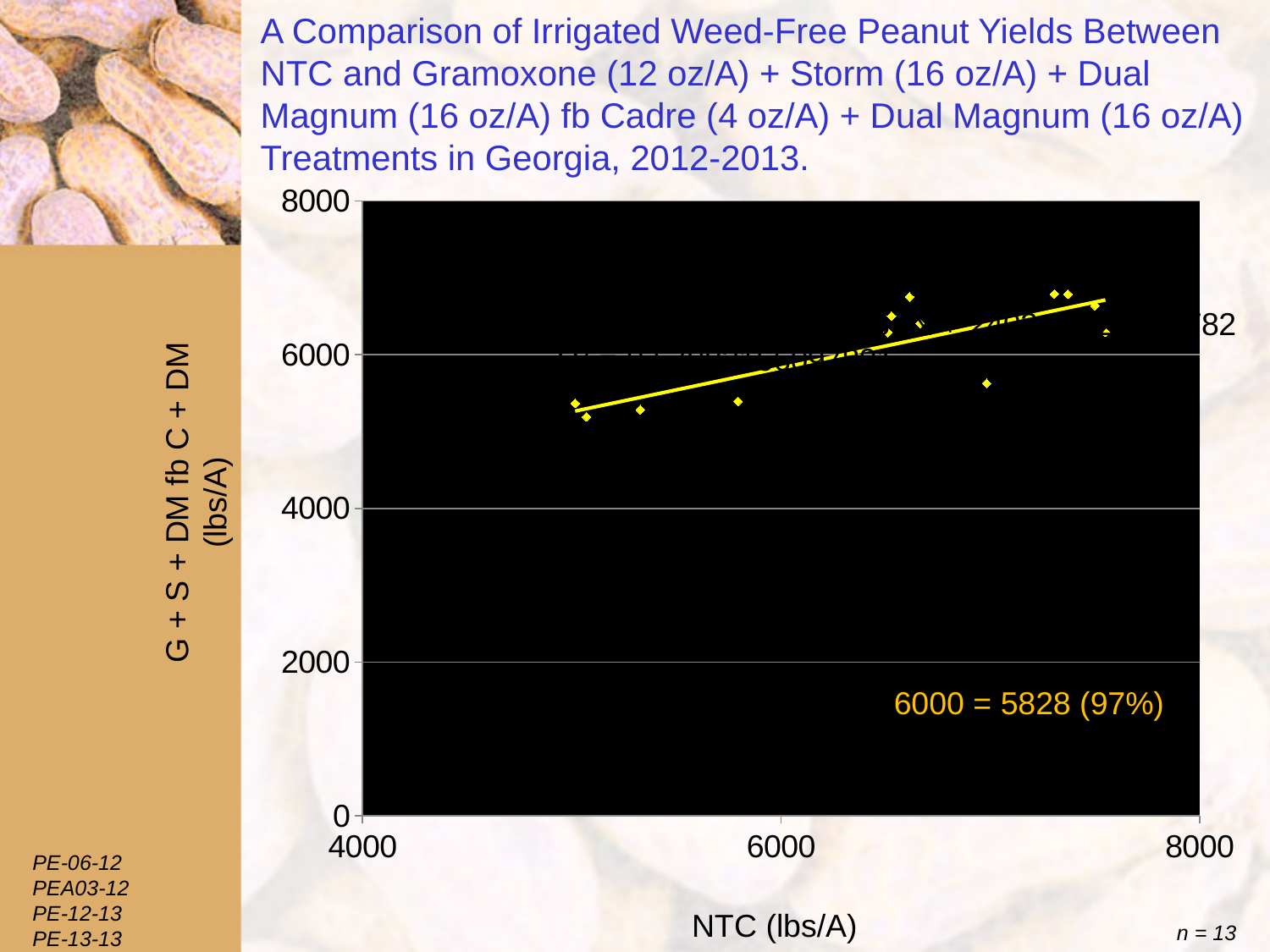
How many data points are plotted, according to the note on the slide? 13 What is the label of the x axis? NTC (lbs/A) Is the lowest plotted point on the y axis greater or less than 4000? greater Is the leftmost plotted point's NTC value greater or less than 6000? less Is the highest plotted point on the y axis greater or less than 6000? greater What is the maximum value shown on the y axis? 8000 Do the plotted values rise or fall as NTC yield increases along the x axis? rise What is the label of the y axis? G + S + DM fb C + DM (lbs/A) According to the annotation on the chart, what treated yield corresponds to an NTC yield of 6000? 5828 (97%) What kind of chart is shown on the slide? scatter chart